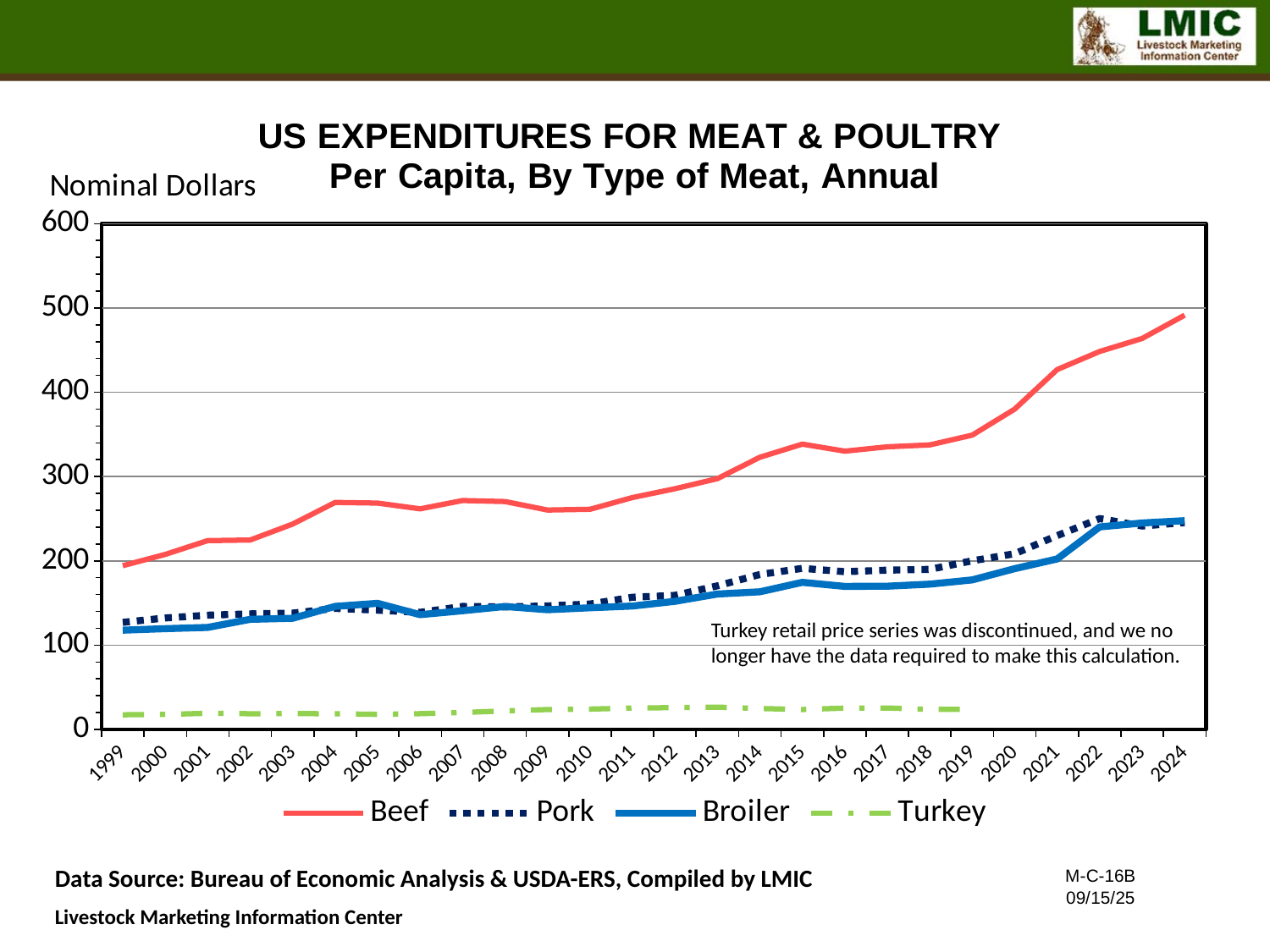
How many years are shown along the x axis? 26 Is the value for Beef in 2010 greater or less than 300? less Is the value for Broiler in 1999 greater or less than 200? less Which series has the lowest values throughout the chart? Turkey Is the value for Pork in 2024 greater or less than 200? greater Does the Beef series generally rise or fall from 1999 to 2024? Rise In 2024, which is larger, the value for Beef or the value for Broiler? Beef Which series has the highest value in 2024? Beef What label is shown on the y axis of the chart? Nominal Dollars What kind of chart is shown on the slide? Line chart How many series does the legend list? 4